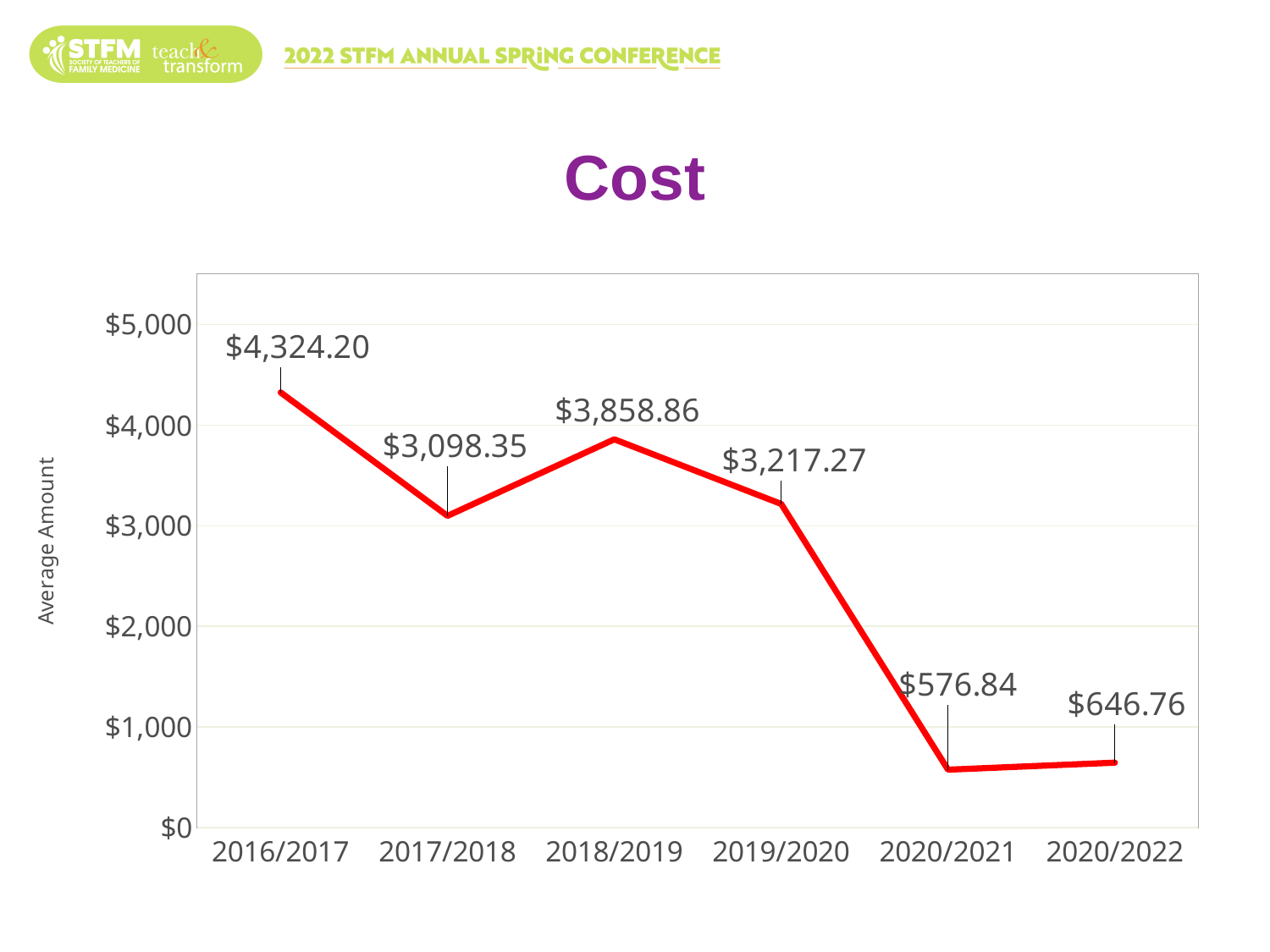
What kind of chart is shown on the slide? Line chart Which period has the highest average amount? 2016/2017 How many periods are plotted on the chart? 6 What is the difference between the average amounts for 2018/2019 and 2019/2020? $641.59 What is the average amount for 2016/2017? $4,324.20 Which period has the lowest average amount? 2020/2021 What is the title of the chart? Cost What is the average amount for 2020/2021? $576.84 What is the difference between the average amounts for 2016/2017 and 2017/2018? $1,225.85 What is the average amount for 2018/2019? $3,858.86 Which is larger, the average amount for 2017/2018 or for 2019/2020? 2019/2020 What is the average amount for 2020/2022? $646.76